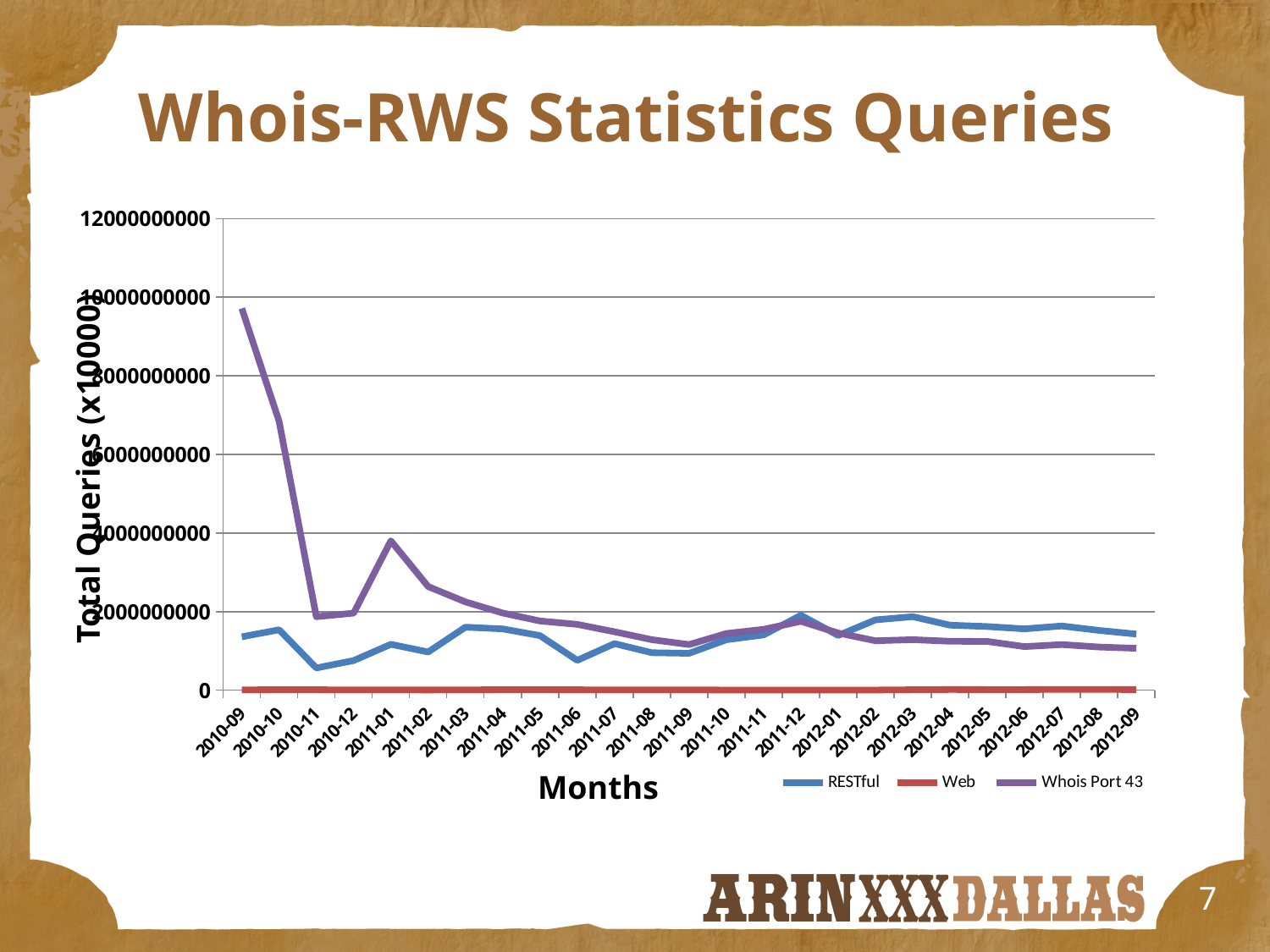
Is the value for Whois Port 43 in 2010-09 greater or less than 8000000000? greater Is the value for Whois Port 43 in 2011-01 greater or less than 2000000000? greater What is the title of the x axis? Months Which series has the lowest values across all months? Web How many series does the legend list? 3 Does the Whois Port 43 series generally rise or fall from 2010-09 to 2012-09? fall How many months are plotted along the x axis? 25 In which month does the Whois Port 43 series reach its highest value? 2010-09 Is the value for RESTful in 2010-11 greater or less than 2000000000? less In 2010-09, which series has the larger value, RESTful or Whois Port 43? Whois Port 43 In 2012-03, which series has the larger value, RESTful or Whois Port 43? RESTful What kind of chart is shown on the slide? line chart